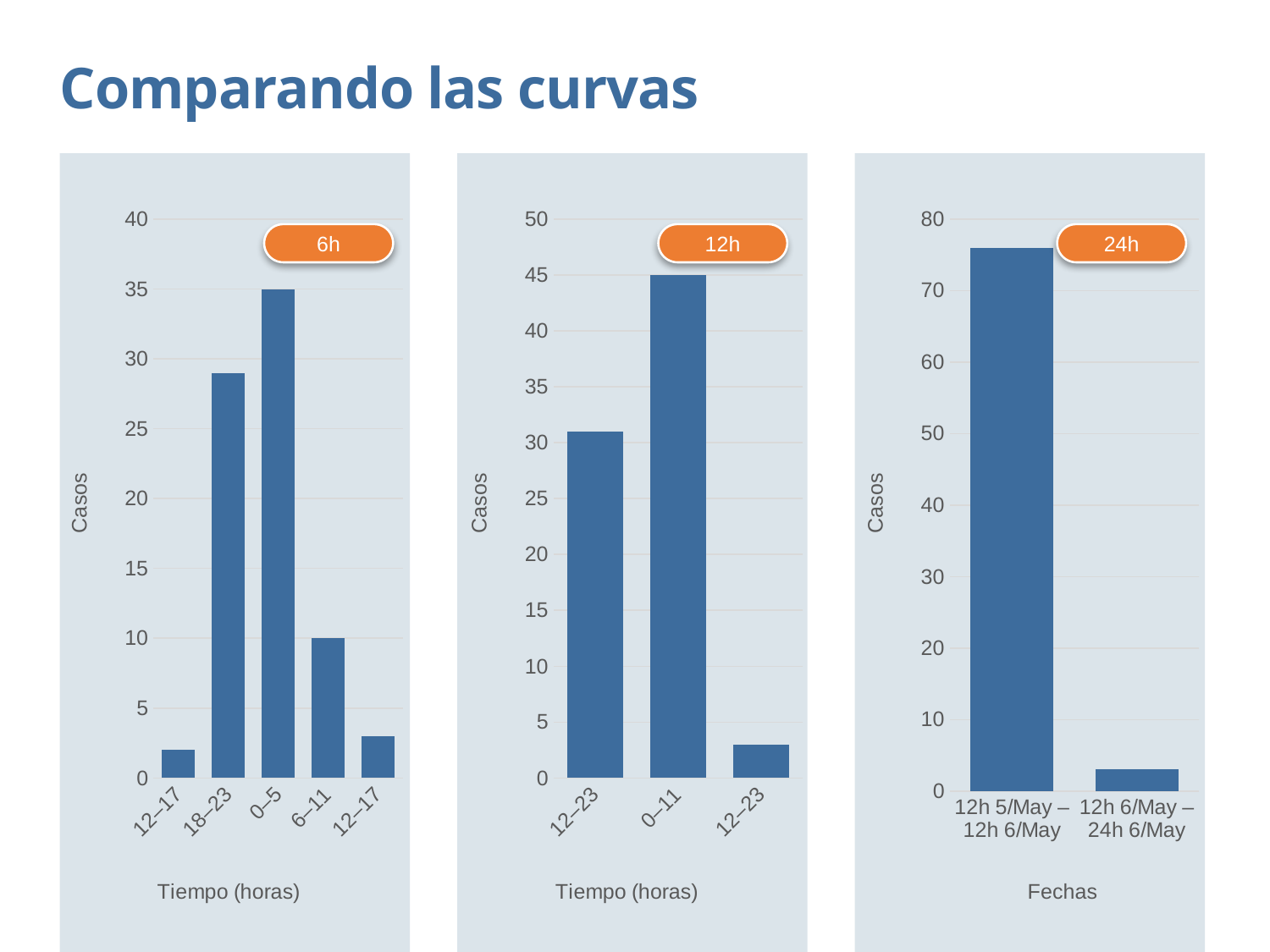
What kind of chart is the left chart labelled 6h? bar chart In the middle chart (12h), how many cases are shown for the 0–11 interval? 45 In the left chart (6h), how many cases are shown for the 0–5 interval? 35 How many bars does the middle chart (12h) have? 3 In the right chart (24h), which period has more cases: 12h 5/May – 12h 6/May or 12h 6/May – 24h 6/May? 12h 5/May – 12h 6/May How many bars does the left chart (6h) have? 5 In the left chart (6h), which time interval has the highest number of cases? 0–5 In the right chart (24h), is the value for 12h 5/May – 12h 6/May greater or less than 70? greater In the middle chart (12h), which time interval has the highest number of cases? 0–11 What is the y-axis title of the right chart (24h)? Casos How many bars does the right chart (24h) have? 2 In the left chart (6h), is the value for the 18–23 interval greater or less than 25? greater